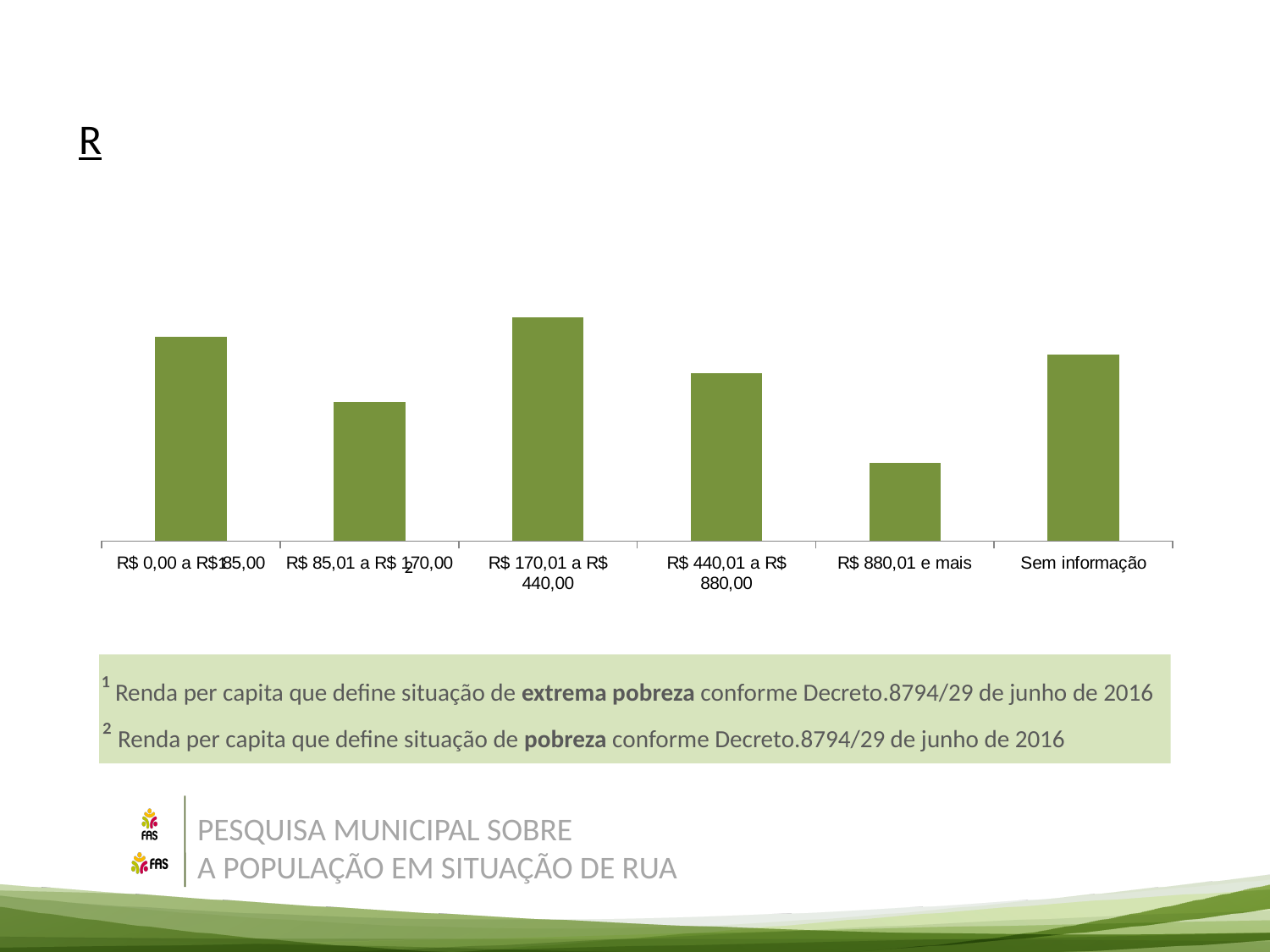
What is the label of the last category on the x axis of the chart? Sem informação Which bar is shorter: R$ 85,01 a R$ 170,00 or R$ 440,01 a R$ 880,00? R$ 85,01 a R$ 170,00 Which bar is taller: R$ 0,00 a R$ 85,00 or R$ 85,01 a R$ 170,00? R$ 0,00 a R$ 85,00 What kind of chart is shown on the slide? bar chart Which bar is taller: Sem informação or R$ 440,01 a R$ 880,00? Sem informação Which category has the lowest bar in the chart? R$ 880,01 e mais Which category has the highest bar in the chart? R$ 170,01 a R$ 440,00 How many categories are shown on the x axis of the chart? 6 What colour are the bars in the chart? green